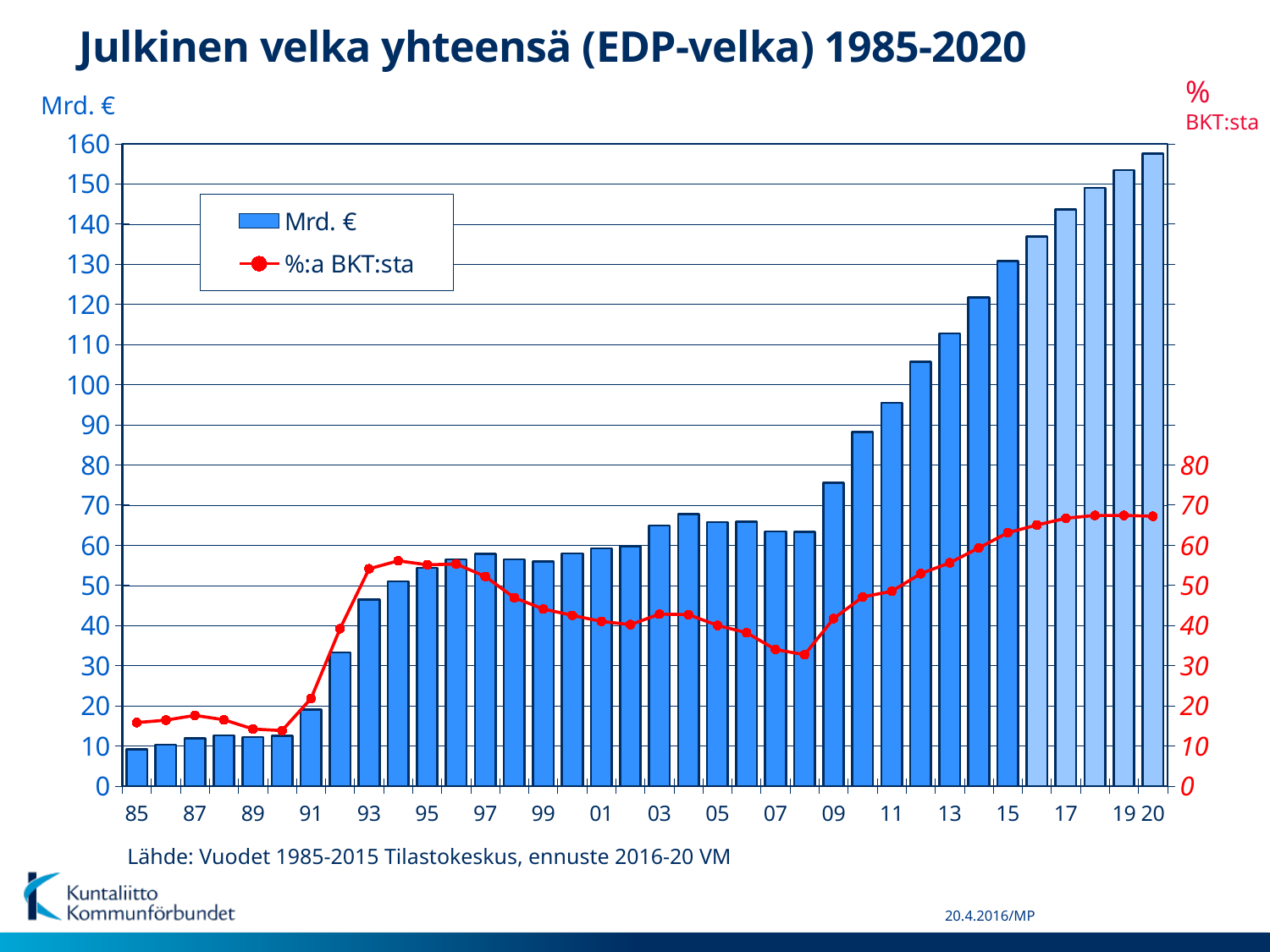
Is the %:a BKT:sta value for 2020 greater or less than 60? greater How many series does the legend list? 2 What kind of chart is shown on the slide? A combination bar and line chart How many years (bars) are plotted in the chart? 36 Is the Mrd. € value for 2020 greater or less than 150? greater Is the Mrd. € value for 1993 greater or less than 50? less Which year has the highest bar for Mrd. €? 2020 What is the title of the chart? Julkinen velka yhteensä (EDP-velka) 1985-2020 Do the Mrd. € bars generally rise or fall from 1985 to 2020? rise Which year has the larger Mrd. € bar, 2004 or 2008? 2004 Which year has the lowest bar for Mrd. €? 1985